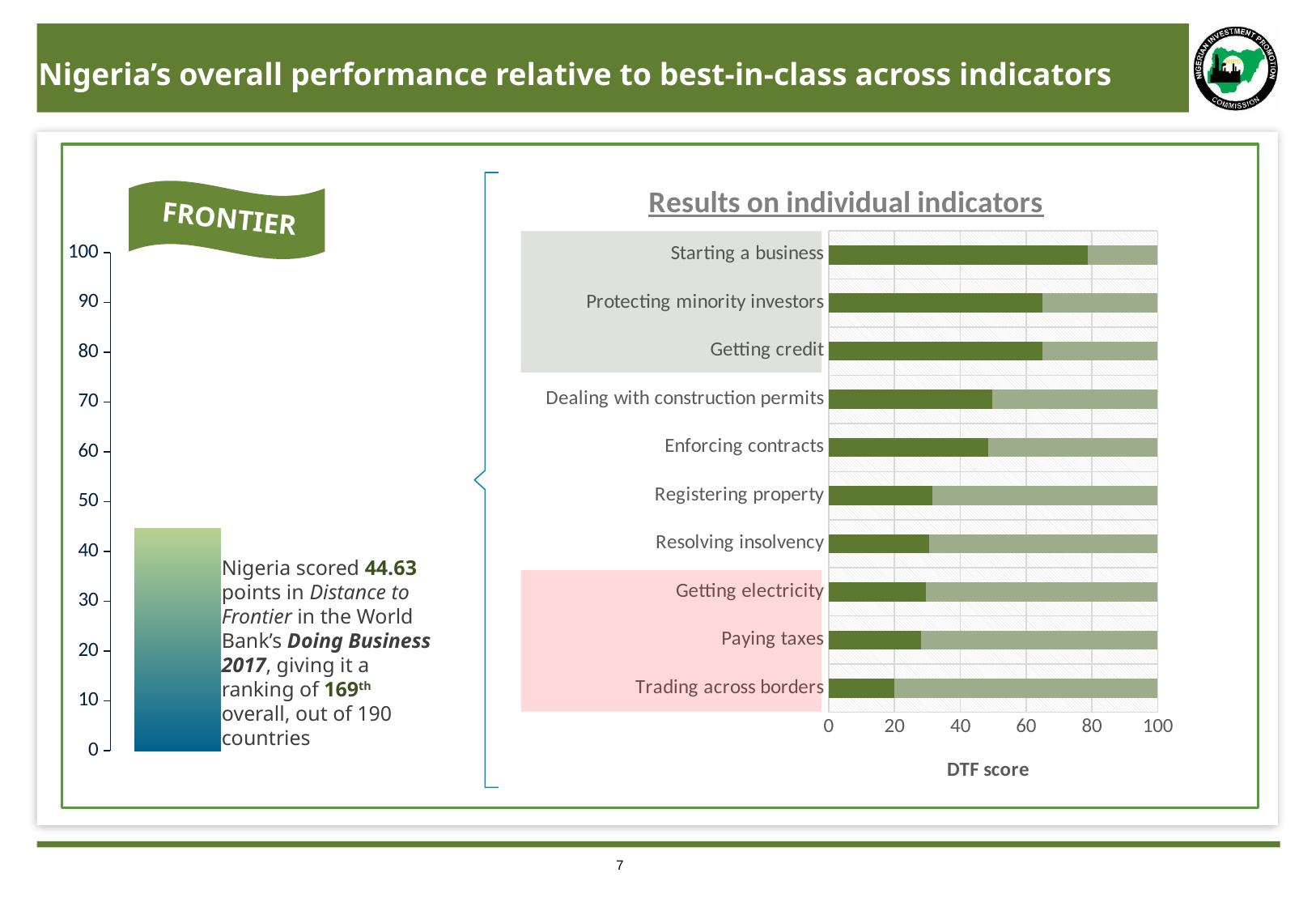
In the 'Results on individual indicators' chart, is the DTF score for Trading across borders greater or less than 40? less In the 'Results on individual indicators' chart, what is the label on the horizontal axis? DTF score In the 'Results on individual indicators' chart, which has a higher DTF score: Dealing with construction permits or Paying taxes? Dealing with construction permits In the 'Results on individual indicators' chart, which indicator has the highest DTF score? Starting a business In the 'Results on individual indicators' chart, do the DTF scores rise or fall going from the top indicator to the bottom indicator? fall In the 'Results on individual indicators' chart, is the DTF score for Starting a business greater or less than 60? greater In the 'Results on individual indicators' chart, is the DTF score for Protecting minority investors greater or less than 40? greater In the 'Results on individual indicators' chart, which indicator has the lowest DTF score? Trading across borders In the 'Results on individual indicators' chart, how many indicators are plotted? 10 In the 'Results on individual indicators' chart, what kind of chart is used? bar chart In the 'Results on individual indicators' chart, what is the maximum value shown on the horizontal axis? 100